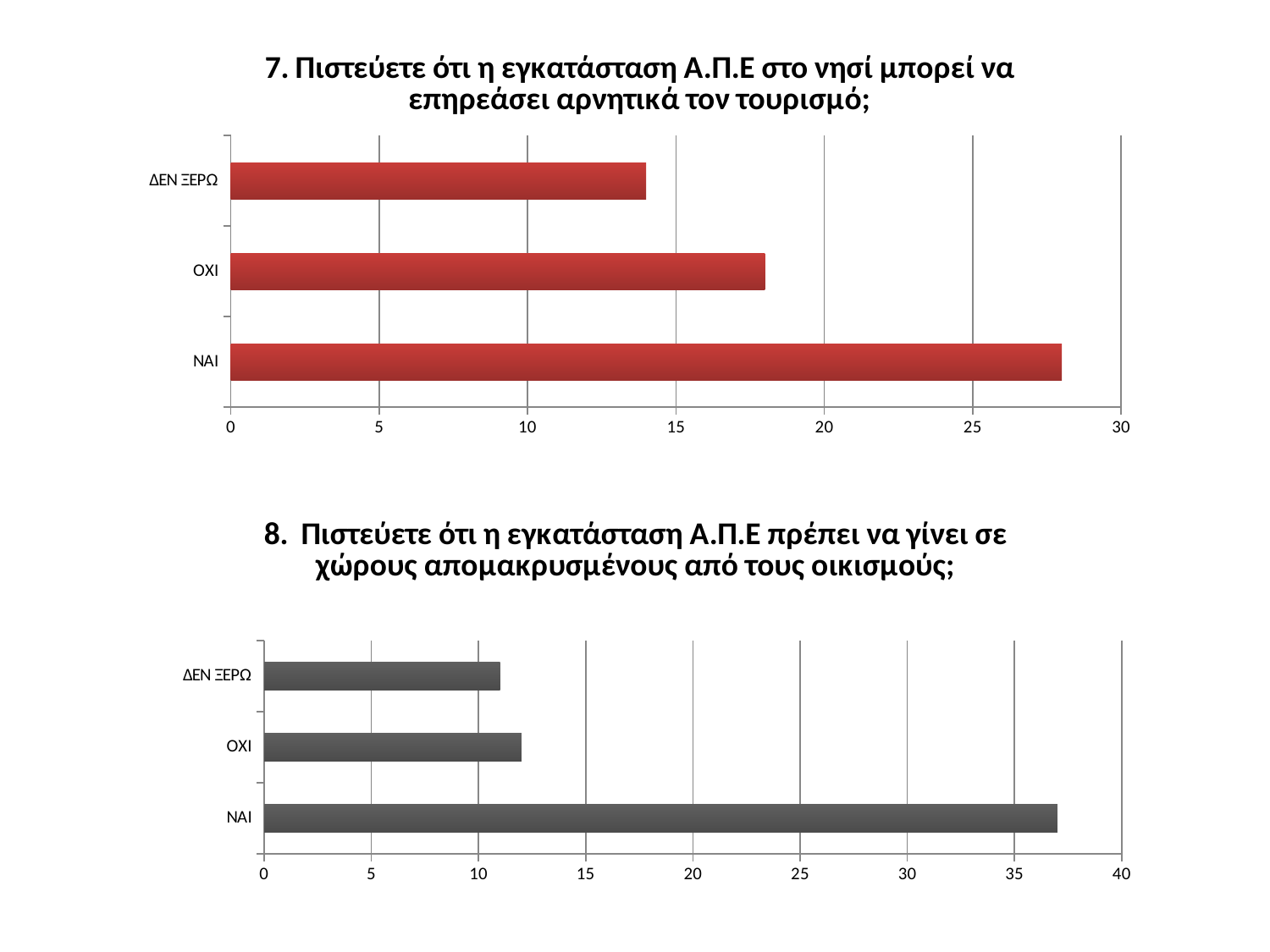
In the top chart (question 7), which category has the highest value? ΝΑΙ In the top chart (question 7), which category has the lowest value? ΔΕΝ ΞΕΡΩ In the top chart (question 7), is the value for ΟΧΙ greater or less than 20? less In the top chart (question 7), which is larger, the value for ΟΧΙ or the value for ΔΕΝ ΞΕΡΩ? ΟΧΙ In the bottom chart (question 8), is the value for ΔΕΝ ΞΕΡΩ greater or less than 15? less What kind of chart is the top chart (question 7)? Bar chart In the top chart (question 7), is the value for ΔΕΝ ΞΕΡΩ greater or less than 10? greater In the bottom chart (question 8), which is larger, the value for ΝΑΙ or the value for ΟΧΙ? ΝΑΙ In the bottom chart (question 8), which category has the highest value? ΝΑΙ How many categories are shown in the bottom chart (question 8)? 3